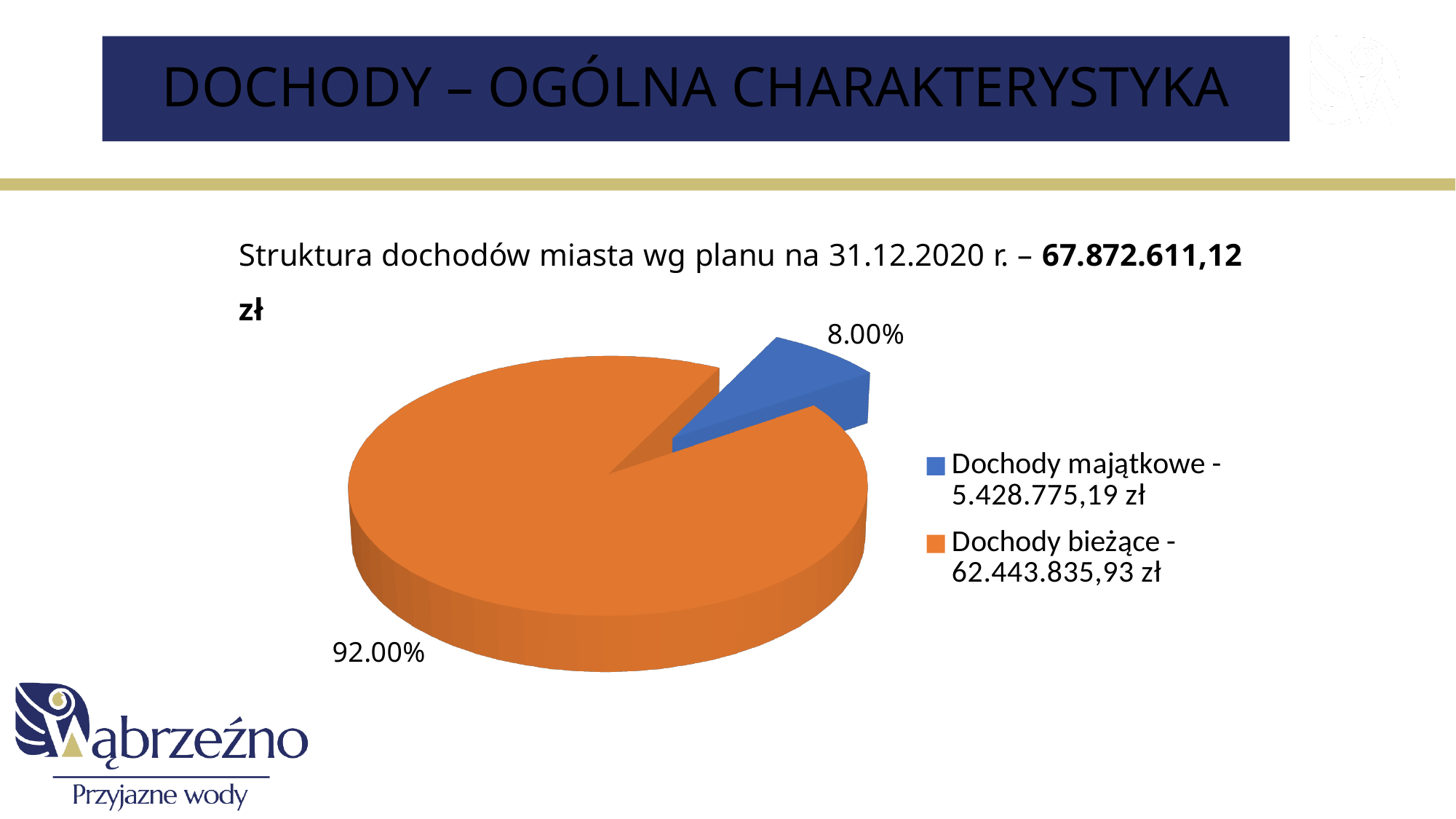
What is the value for Dochody bieżące shown in the legend? 62.443.835,93 zł What is the value for Dochody majątkowe shown in the legend? 5.428.775,19 zł How many entries does the legend list? 2 What colour is the Dochody majątkowe slice? blue What share of the pie does Dochody bieżące represent? 92.00% Which category has the largest slice of the pie? Dochody bieżące Which category has the smallest slice of the pie? Dochody majątkowe What kind of chart is shown on the slide? pie chart What share of the pie does Dochody majątkowe represent? 8.00% What is the difference in percentage points between the Dochody bieżące and Dochody majątkowe slices? 84.00% Which is larger, Dochody majątkowe or Dochody bieżące? Dochody bieżące How many slices does the pie chart have? 2